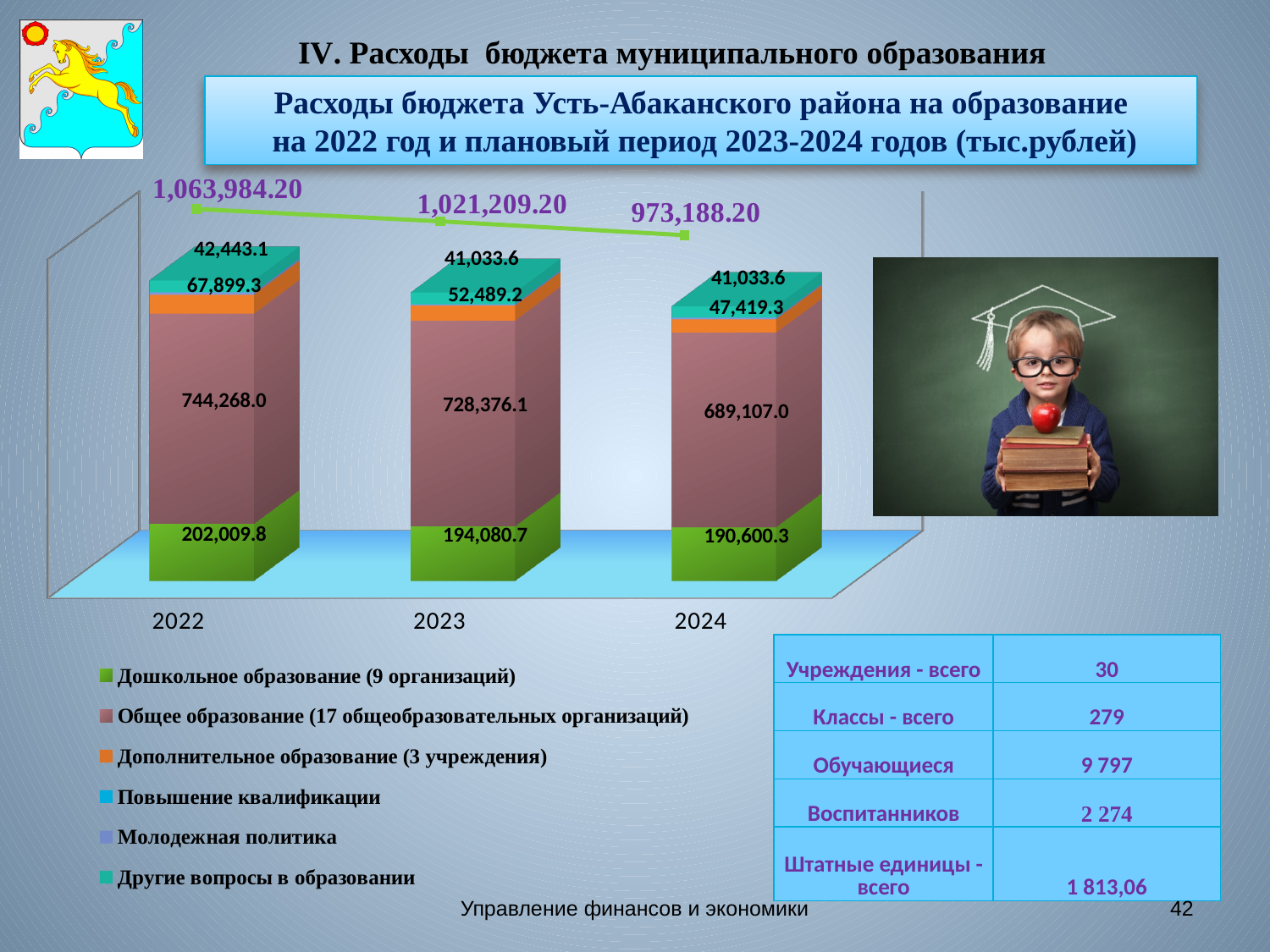
What is the difference between the Дошкольное образование values for 2022 and 2024? 11,409.5 Which year has the lowest total expenditure on education? 2024 How many series does the legend list? 6 What is the value for Дополнительное образование in 2023? 52,489.2 What kind of chart is used to show the education expenditures? Stacked bar chart Which is larger: Дополнительное образование in 2022 or in 2024? 2022 Do the total expenditures rise or fall from 2022 to 2024? Fall What is the value for Общее образование in 2024? 689,107.0 What is the value for Дошкольное образование in 2022? 202,009.8 What is the total shown above the bar for 2023? 1,021,209.20 Which year has the highest value for Общее образование? 2022 How many years are shown on the x axis of the chart? 3